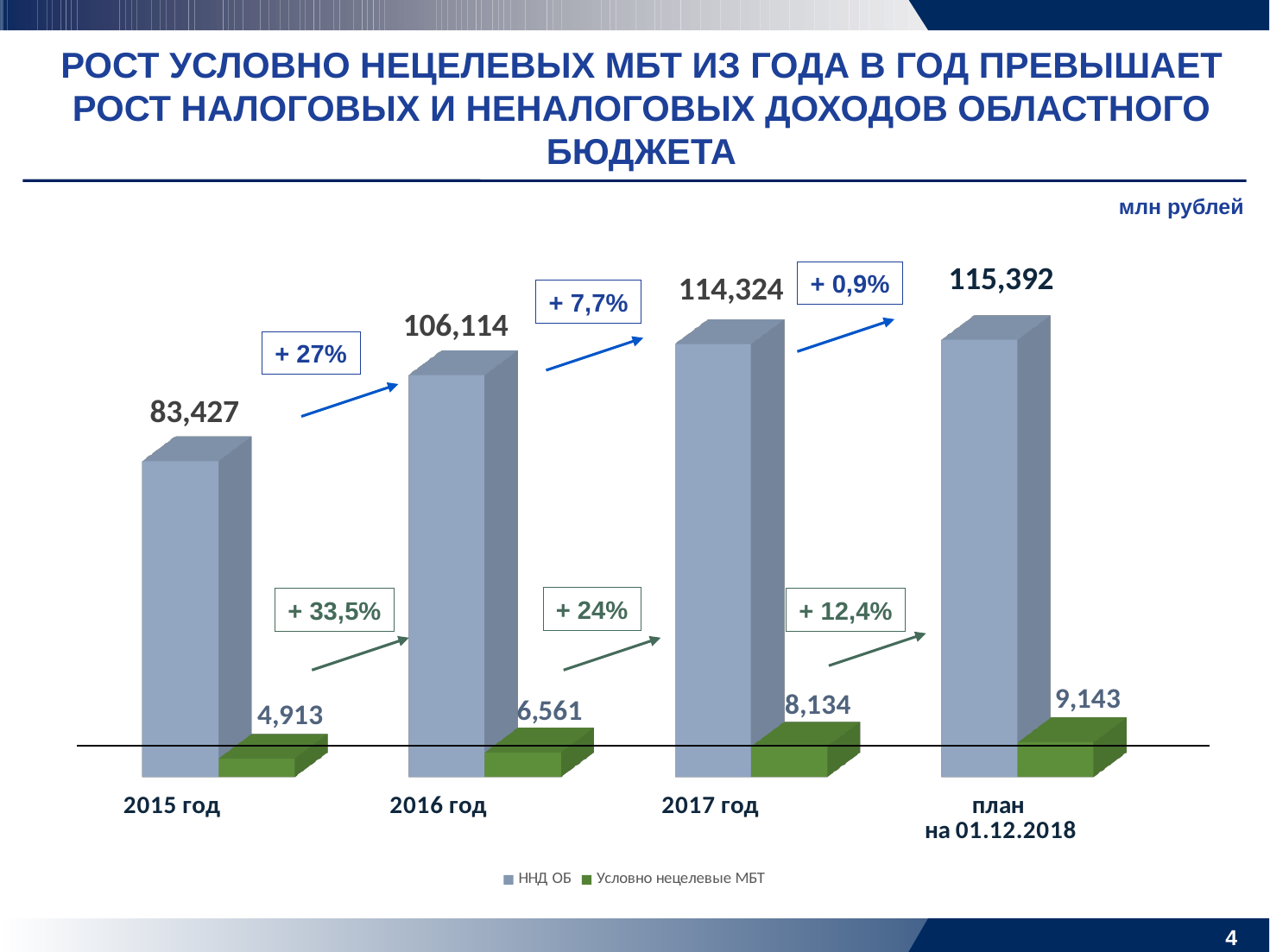
What is the value of Условно нецелевые МБТ for 2017 год? 8,134 Which category has the lowest value for ННД ОБ? 2015 год Which category has the highest value for Условно нецелевые МБТ? план на 01.12.2018 Which is larger: ННД ОБ for 2017 год or ННД ОБ for 2016 год? 2017 год How many series does the legend list? 2 What is the difference between the Условно нецелевые МБТ values for план на 01.12.2018 and 2015 год? 4,230 What is the value of Условно нецелевые МБТ for 2016 год? 6,561 How many categories are shown on the x axis? 4 What is the value of ННД ОБ for план на 01.12.2018? 115,392 What kind of chart is shown on the slide? Bar chart What is the value of ННД ОБ for 2015 год? 83,427 What is the difference between the ННД ОБ values for 2016 год and 2015 год? 22,687